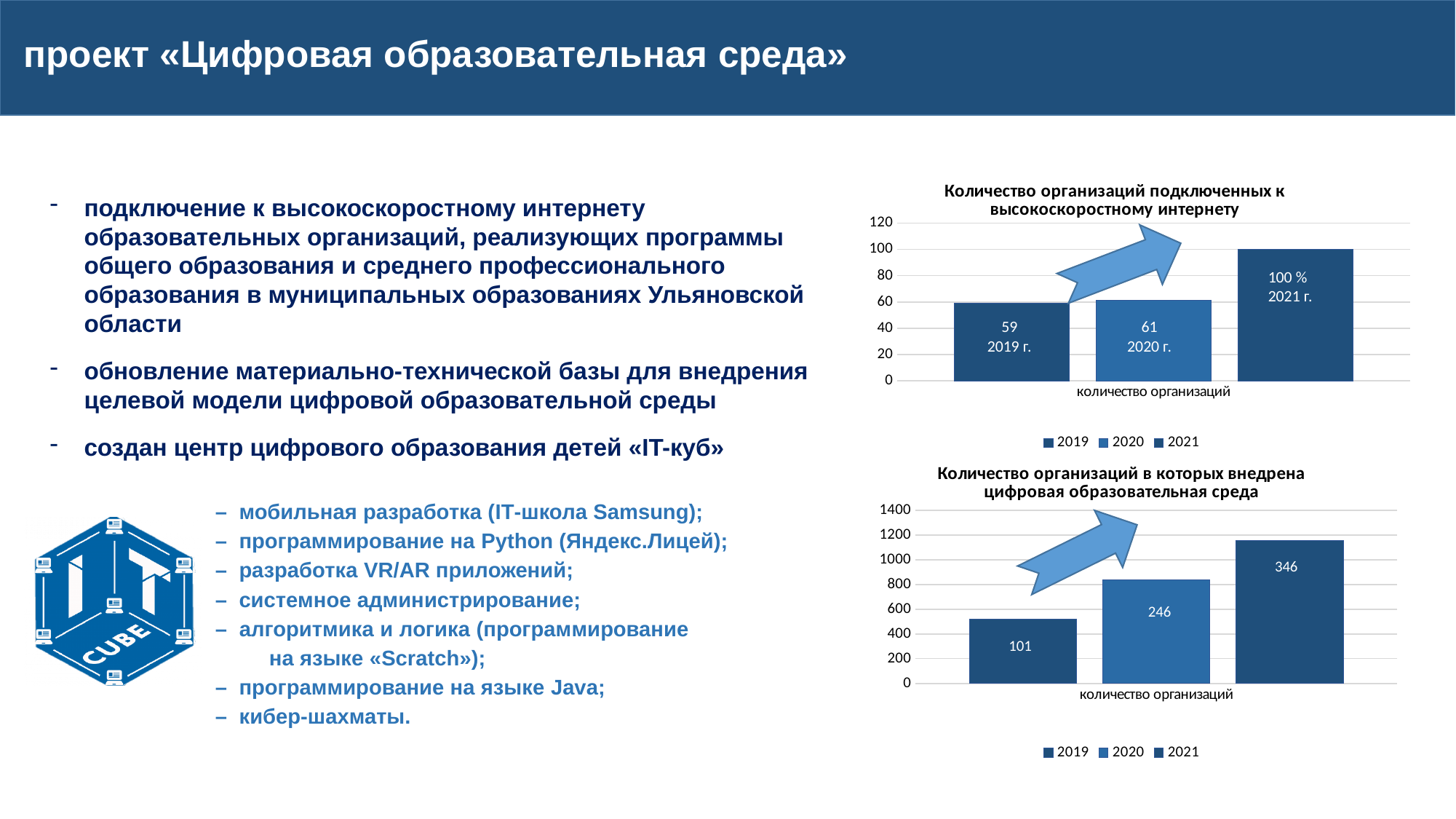
In the top chart (Количество организаций подключенных к высокоскоростному интернету), which year has the highest bar? 2021 In the top chart (Количество организаций подключенных к высокоскоростному интернету), what is the difference between the 2020 and 2019 values? 2 How many series does the legend of the bottom chart (Количество организаций в которых внедрена цифровая образовательная среда) list? 3 In the top chart (Количество организаций подключенных к высокоскоростному интернету), what is the value for 2019? 59 In the top chart (Количество организаций подключенных к высокоскоростному интернету), which year has the lowest value? 2019 In the top chart (Количество организаций подключенных к высокоскоростному интернету), what label is shown on the 2021 bar? 100 % What type of chart is the top chart (Количество организаций подключенных к высокоскоростному интернету)? bar chart In the top chart (Количество организаций подключенных к высокоскоростному интернету), what is the value for 2020? 61 In the bottom chart (Количество организаций в которых внедрена цифровая образовательная среда), do the values rise or fall from 2019 to 2021? rise